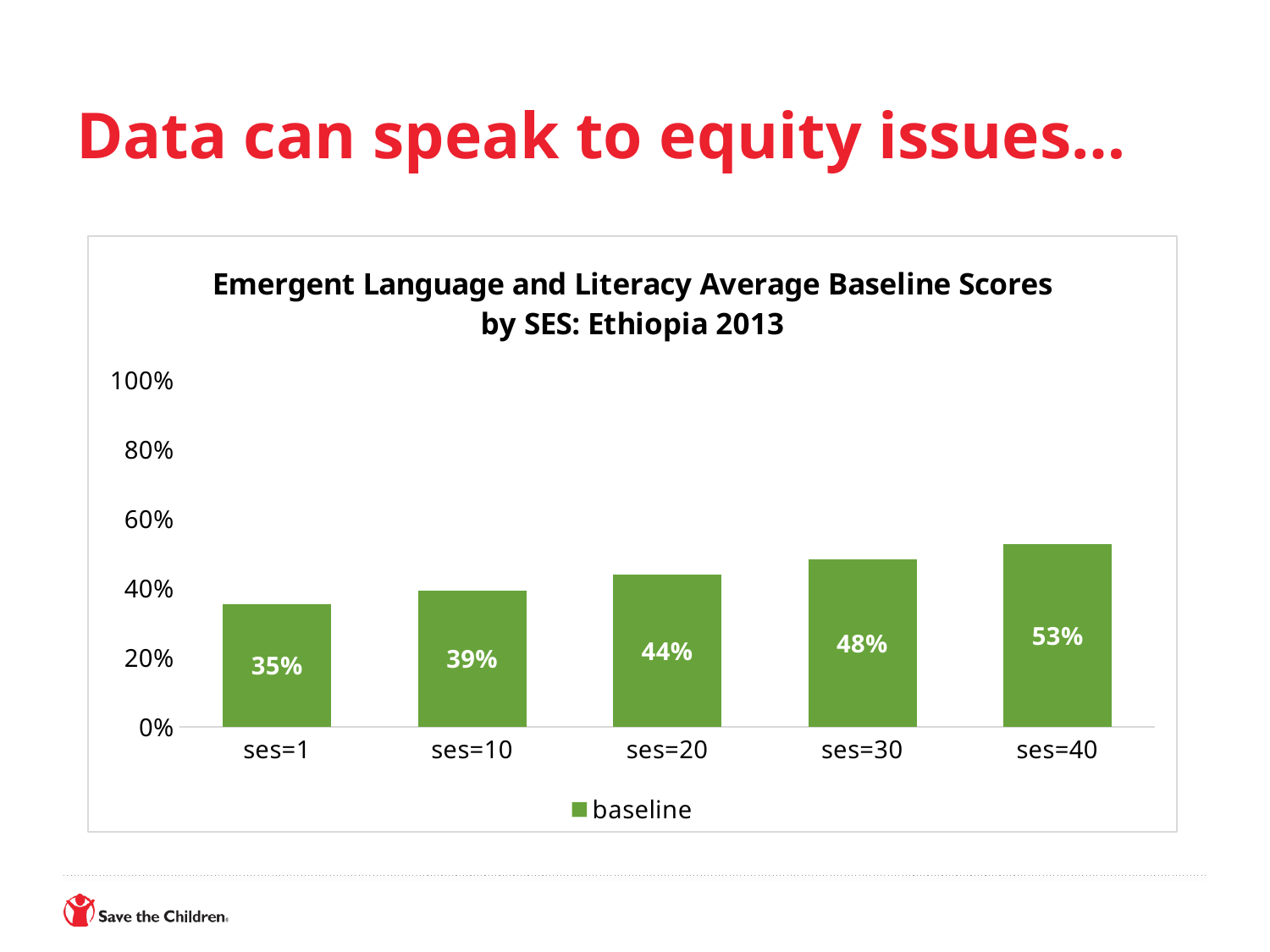
Is the baseline score for ses=40 greater or less than 60%? less What is the baseline score for ses=30? 48% What is the difference between the baseline scores for ses=40 and ses=1? 18% Which has a higher baseline score, ses=10 or ses=30? ses=30 Which SES category has the lowest baseline score? ses=1 What is the baseline score for ses=1? 35% Do the baseline scores rise or fall as SES increases from ses=1 to ses=40? rise What is the difference between the baseline scores for ses=20 and ses=10? 5% Which SES category has the highest baseline score? ses=40 What is the baseline score for ses=20? 44% How many SES categories are shown in the chart? 5 What kind of chart is shown on the slide? bar chart